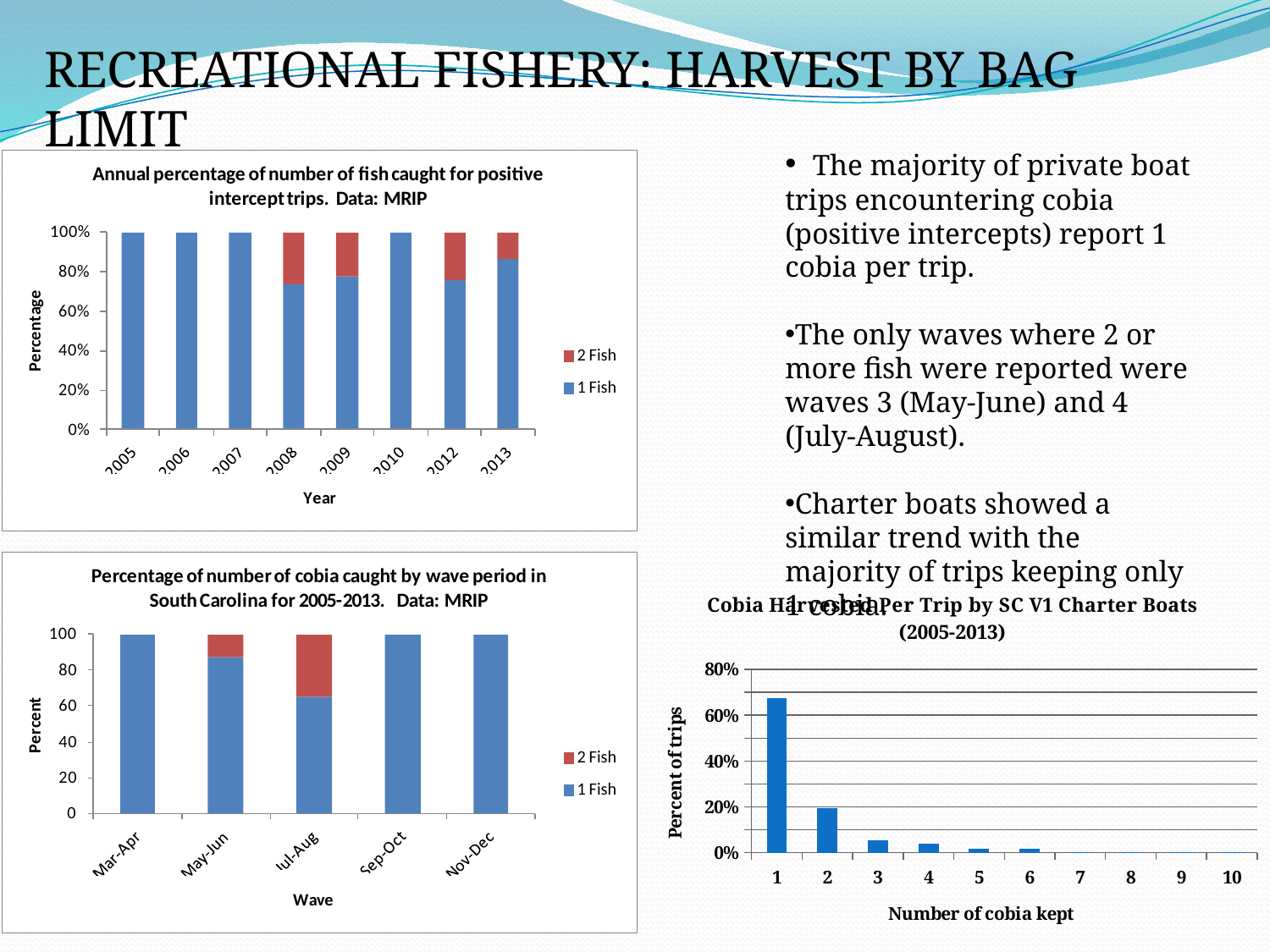
In the 'Percentage of number of cobia caught by wave period in South Carolina' chart, which wave has the largest 2 Fish share? Jul-Aug How many series does the legend list in the 'Annual percentage of number of fish caught for positive intercept trips' chart? 2 In the 'Percentage of number of cobia caught by wave period in South Carolina' chart, is the 1 Fish value for Jul-Aug greater or less than 80? less In the 'Cobia Harvested Per Trip by SC V1 Charter Boats' chart, which number of cobia kept has the highest percent of trips? 1 In the 'Cobia Harvested Per Trip by SC V1 Charter Boats' chart, is the percent of trips for 1 cobia kept greater or less than 60%? greater In the 'Cobia Harvested Per Trip by SC V1 Charter Boats' chart, do the values rise or fall as the number of cobia kept increases? fall In the 'Cobia Harvested Per Trip by SC V1 Charter Boats' chart, is the percent of trips for 2 cobia kept greater or less than 40%? less In the 'Annual percentage of number of fish caught for positive intercept trips' chart, what colour represents the 2 Fish series? Red How many wave periods are shown on the x axis of the 'Percentage of number of cobia caught by wave period in South Carolina' chart? 5 What kind of chart is the 'Cobia Harvested Per Trip by SC V1 Charter Boats (2005-2013)' chart? Bar chart How many years are shown on the x axis of the 'Annual percentage of number of fish caught for positive intercept trips' chart? 8